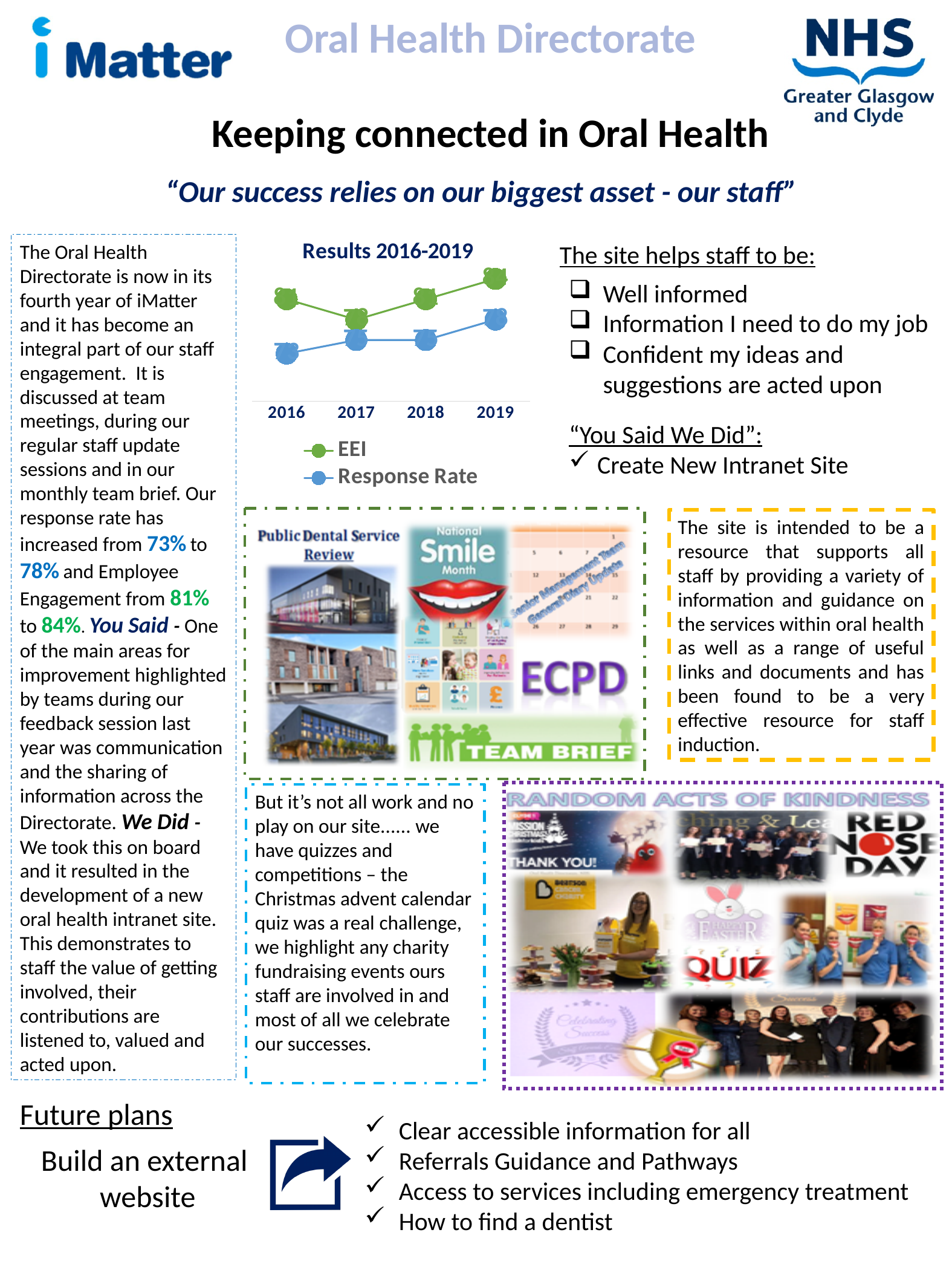
What kind of chart is the "Results 2016-2019" chart? Line chart In the "Results 2016-2019" chart, in which year is the Response Rate highest? 2019 How many series does the legend of the "Results 2016-2019" chart list? 2 In the "Results 2016-2019" chart, in which year is EEI highest? 2019 What is the title of the line chart on the slide? Results 2016-2019 In the "Results 2016-2019" chart, in which year is the Response Rate lowest? 2016 How many years are plotted along the x axis of the "Results 2016-2019" chart? 4 In the "Results 2016-2019" chart, does the Response Rate rise or fall from 2016 to 2019? Rise In the "Results 2016-2019" chart, in which year is EEI lowest? 2017 In the "Results 2016-2019" chart, which series is higher in 2018, EEI or Response Rate? EEI In the "Results 2016-2019" chart, does EEI rise or fall from 2017 to 2019? Rise In the "Results 2016-2019" chart, which series is shown in green? EEI